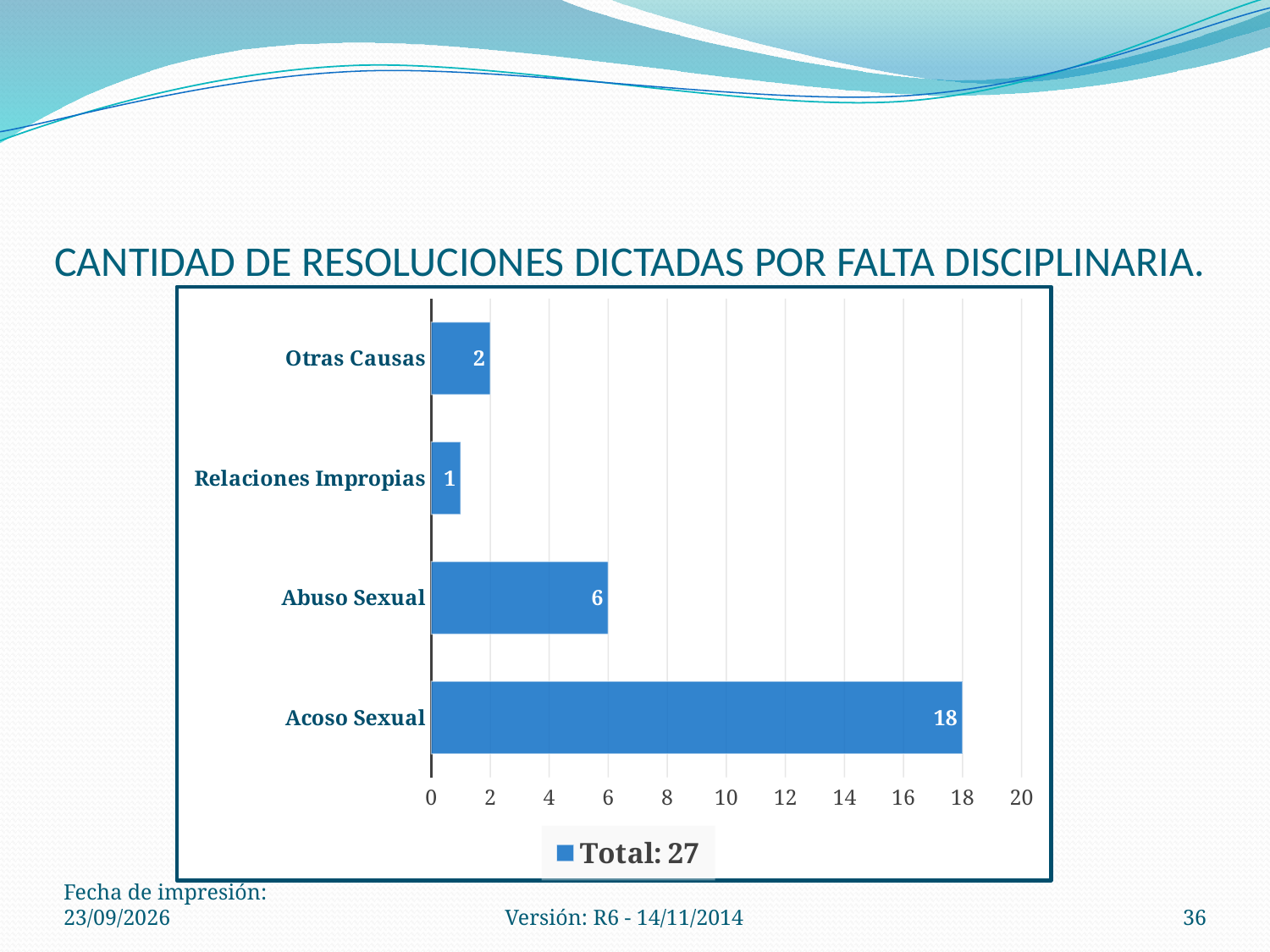
What is the value for Abuso Sexual? 6 What does the legend entry say? Total: 27 Which category has the highest value? Acoso Sexual What is the difference between the values for Acoso Sexual and Abuso Sexual? 12 Which is larger, the value for Otras Causas or the value for Relaciones Impropias? Otras Causas What is the value for Otras Causas? 2 What is the value for Acoso Sexual? 18 Which category has the lowest value? Relaciones Impropias How many categories are shown in the chart? 4 What kind of chart is shown on the slide? bar chart Is the value for Acoso Sexual greater or less than 10? greater What is the value for Relaciones Impropias? 1